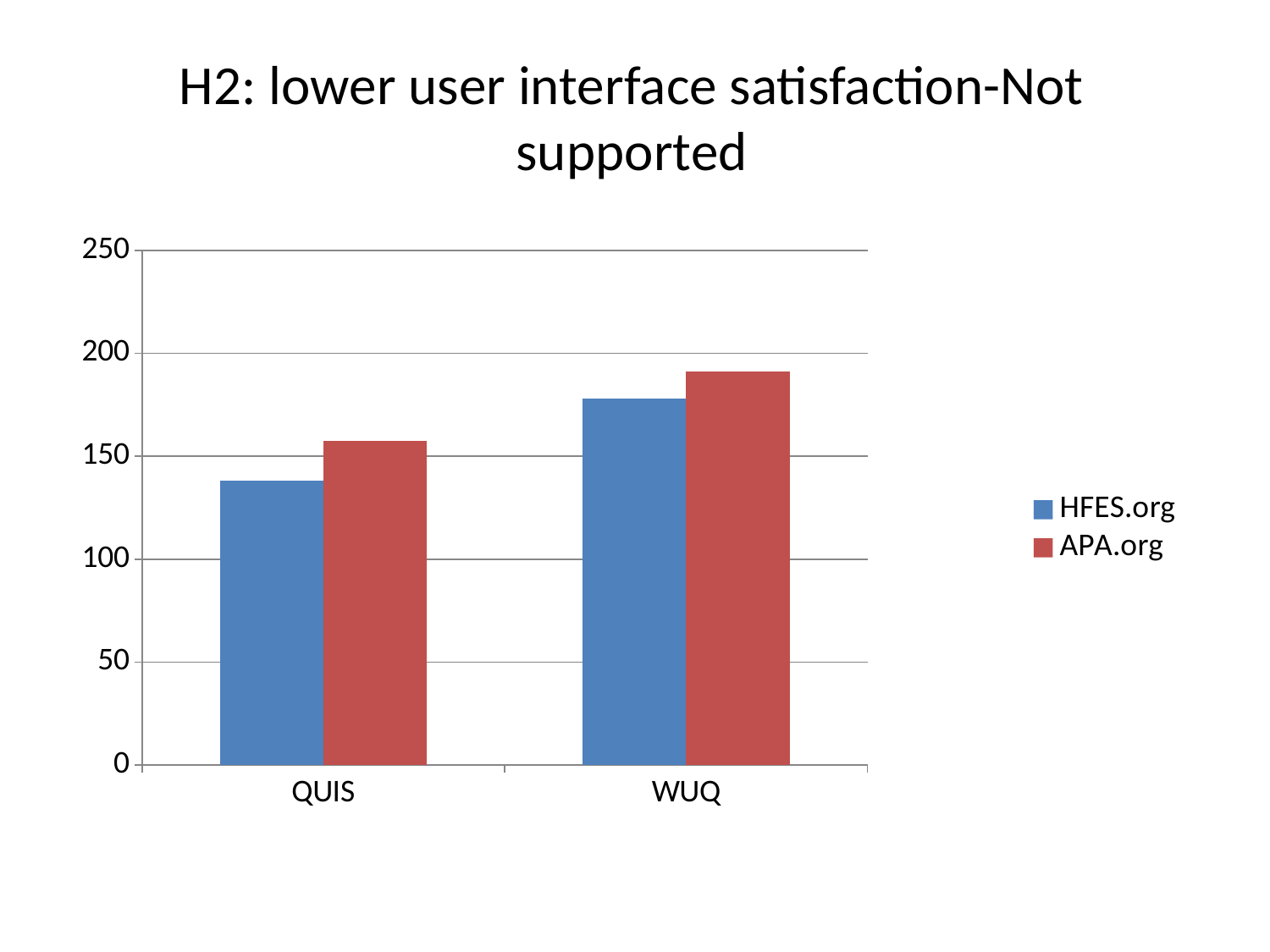
Which category has the highest HFES.org value? WUQ Is the HFES.org value for QUIS greater or less than 150? less Which category has the lowest APA.org value? QUIS What kind of chart is shown on the slide? bar chart How many categories are shown on the x axis? 2 Is the APA.org value for QUIS greater or less than 150? greater For QUIS, which series has the larger value, HFES.org or APA.org? APA.org Which series does the legend list first? HFES.org What colour are the APA.org bars? red Is the APA.org value for WUQ greater or less than 150? greater How many series does the legend list? 2